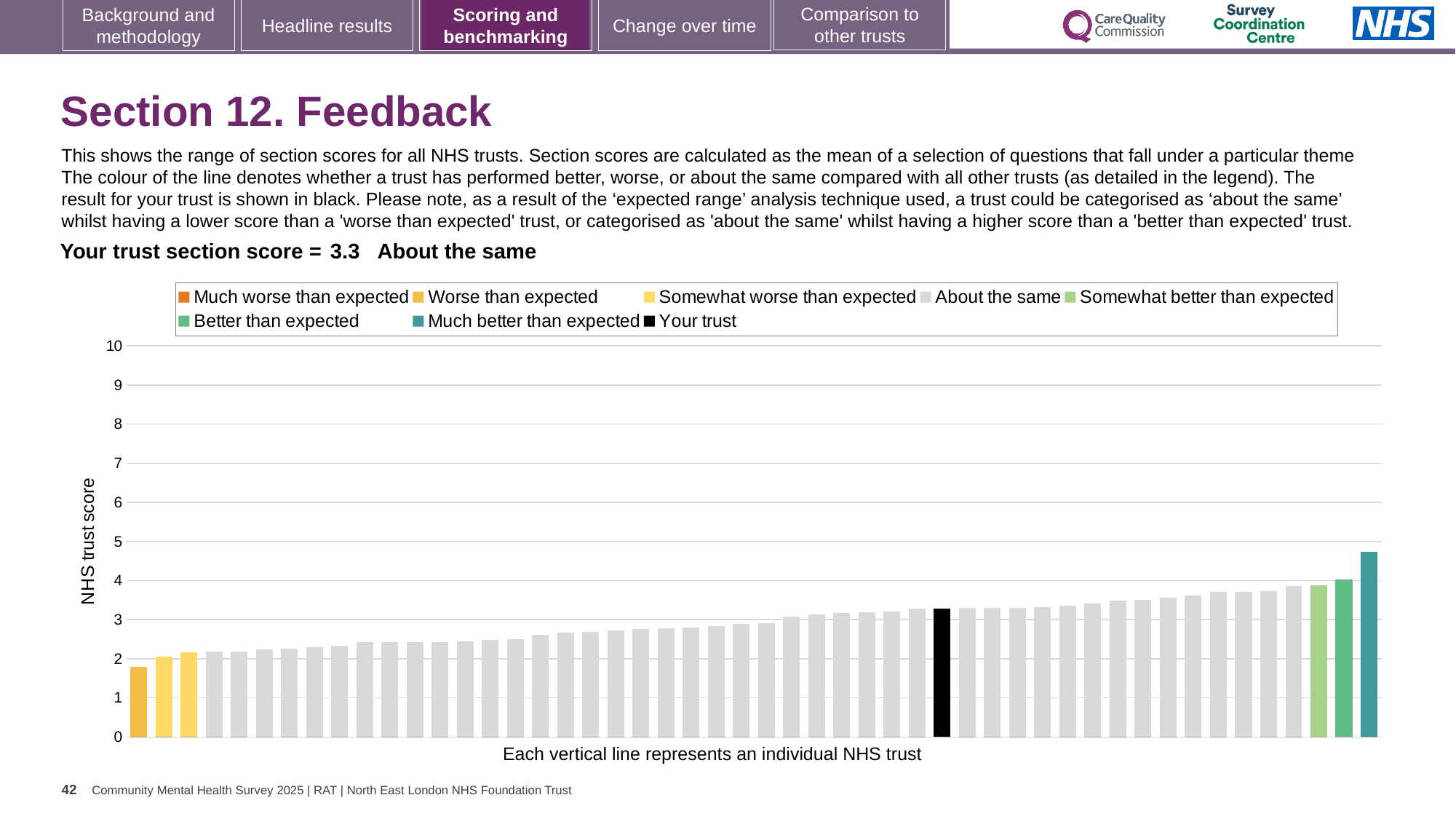
What kind of chart is shown on the slide? bar chart Is the value of the black 'Your trust' bar greater or less than 3? greater How many entries does the chart legend list? 8 Is the value of the tallest bar (rightmost) greater or less than 4? greater What is the label on the y axis of the chart? NHS trust score Which is larger, the black 'Your trust' bar or the leftmost bar? the black 'Your trust' bar What is the section score for your trust shown on the slide? 3.3 Which legend category does the tallest bar belong to? Much better than expected Is the value of the shortest bar (leftmost) greater or less than 2? less How many bars are coloured as 'Much better than expected'? 1 Do the bar values rise or fall from left to right along the x axis? rise Which category is your trust placed in for this section? About the same